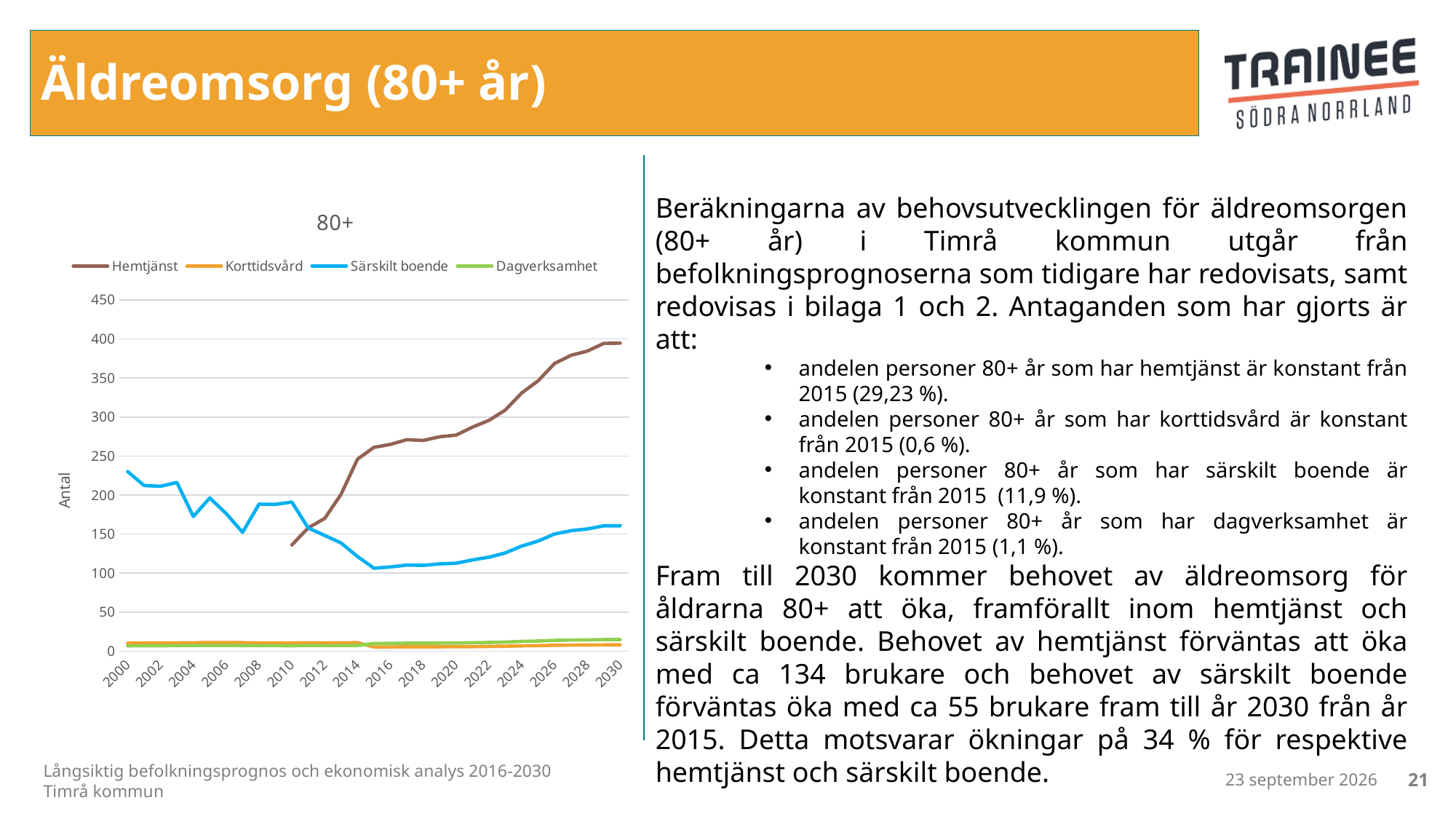
What is the label on the vertical axis of the chart? Antal Does the Hemtjänst line rise or fall between 2010 and 2030? rise Is the value for Särskilt boende in 2000 greater or less than 200? greater In 2010, which is larger: Hemtjänst or Särskilt boende? Särskilt boende What kind of chart is shown on the slide? line chart How many series does the chart legend list? 4 What is the title of the chart? 80+ Which series has the highest value in 2030? Hemtjänst Is the value for Hemtjänst in 2030 greater or less than 350? greater Does the Särskilt boende line rise or fall between 2000 and 2016? fall Is the value for Hemtjänst in 2010 greater or less than 150? less